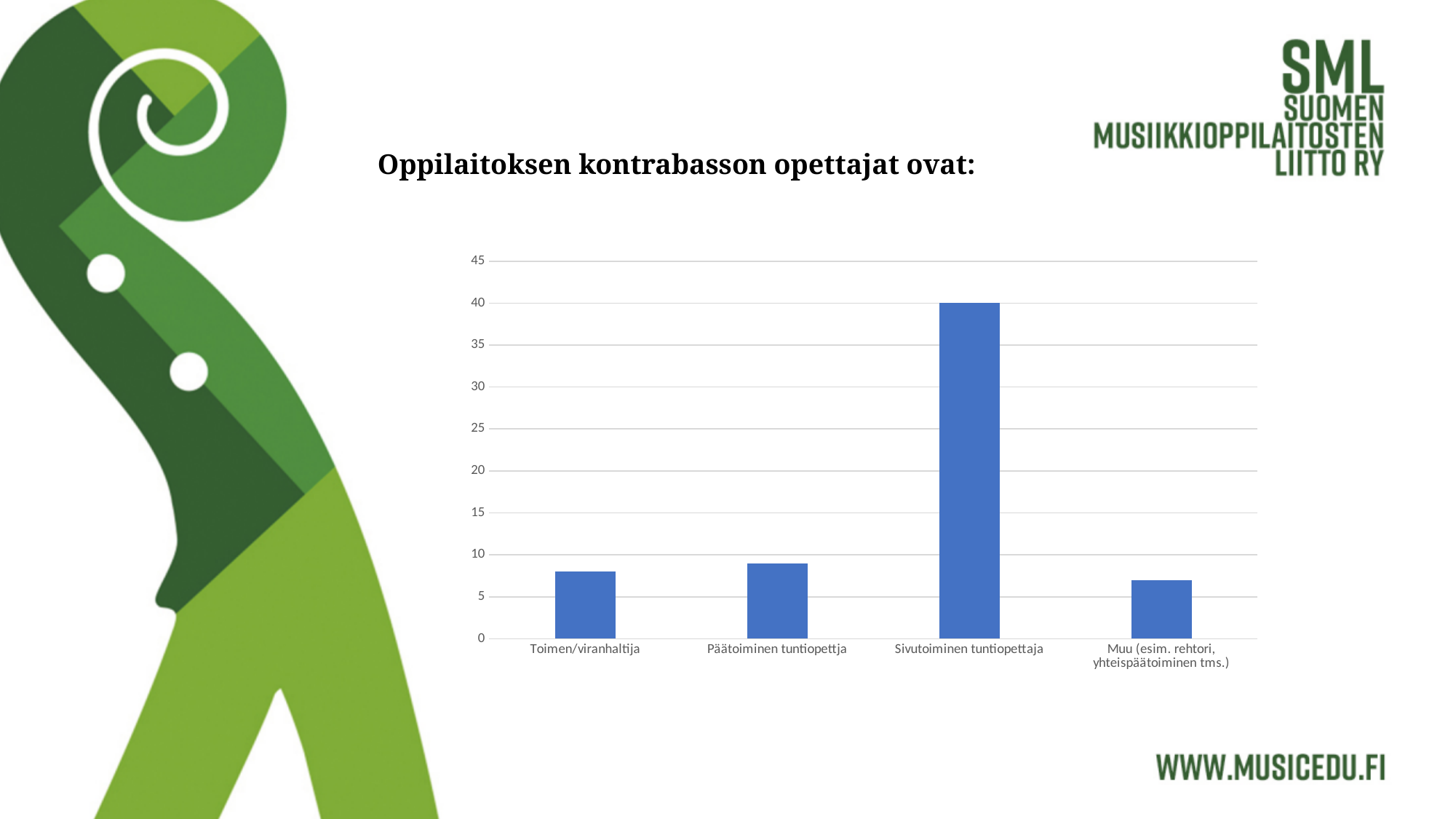
What type of chart is shown on the slide? bar chart Which is larger, the value for Sivutoiminen tuntiopettaja or the value for Toimen/viranhaltija? Sivutoiminen tuntiopettaja What is the highest value shown on the y axis of the chart? 45 Is the value for Sivutoiminen tuntiopettaja greater or less than 35? greater Which category has the highest value? Sivutoiminen tuntiopettaja What is the title of the chart? Oppilaitoksen kontrabasson opettajat ovat: Is the value for Toimen/viranhaltija greater or less than 10? less What is the value for Sivutoiminen tuntiopettaja? 40 Is the value for Muu (esim. rehtori, yhteispäätoiminen tms.) greater or less than 10? less Which is larger, the value for Päätoiminen tuntiopettja or the value for Muu (esim. rehtori, yhteispäätoiminen tms.)? Päätoiminen tuntiopettja How many categories are shown on the x axis of the chart? 4